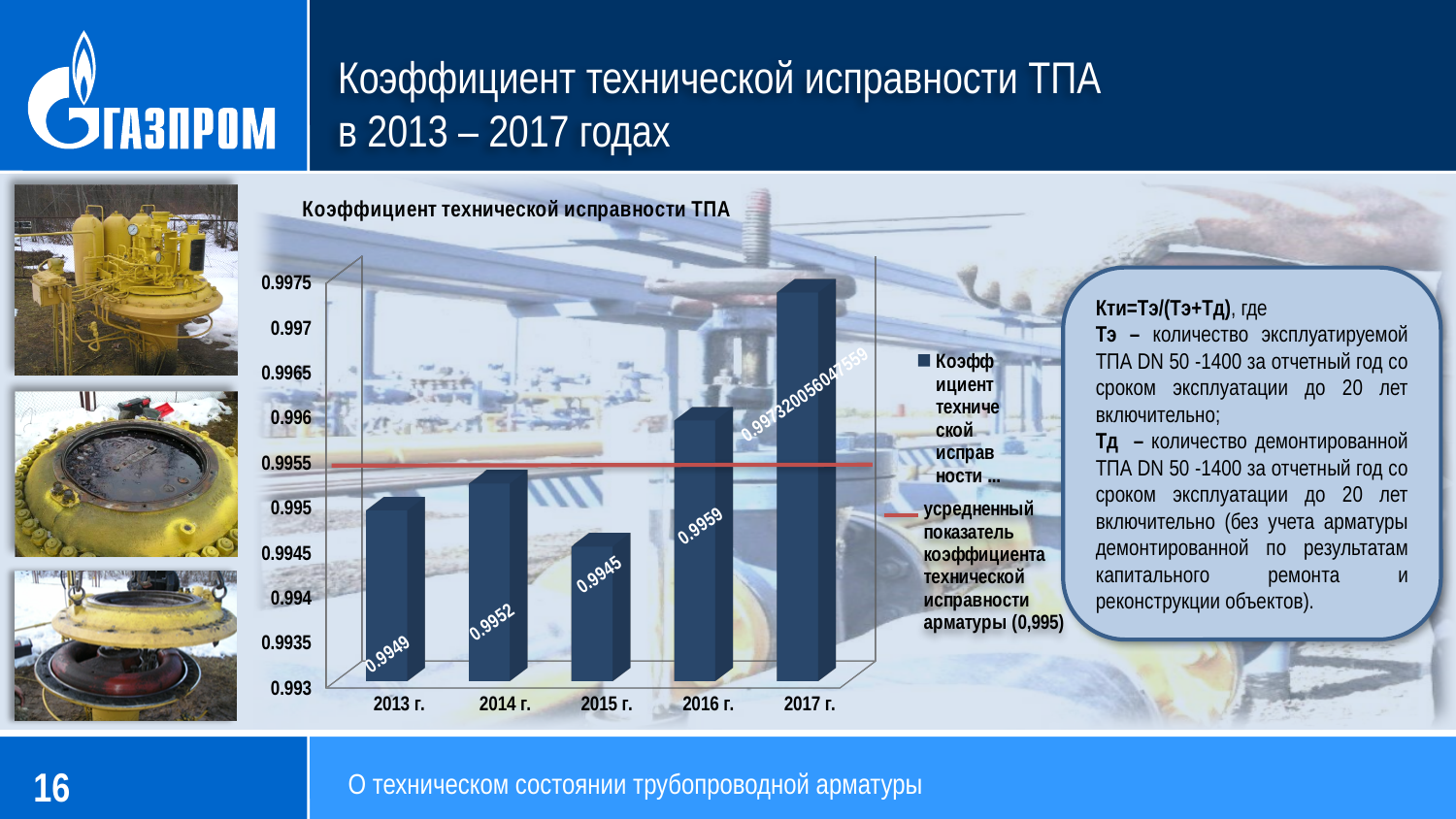
What type of chart is shown on the slide? bar chart Which year has the lowest value in the chart? 2015 г. What is the value for 2015 г. in the chart? 0,9945 What is the value for 2013 г. in the chart? 0,9949 How many entries does the chart legend list? 2 What is the value for 2016 г. in the chart? 0,9959 What is the difference between the values for 2016 г. and 2013 г.? 0,001 Which year has the highest value in the chart? 2017 г. Which is larger, the value for 2014 г. or the value for 2015 г.? 2014 г. What is the value for 2014 г. in the chart? 0,9952 How many years are shown on the x axis of the chart? 5 Is the value for 2017 г. greater or less than 0.997? greater